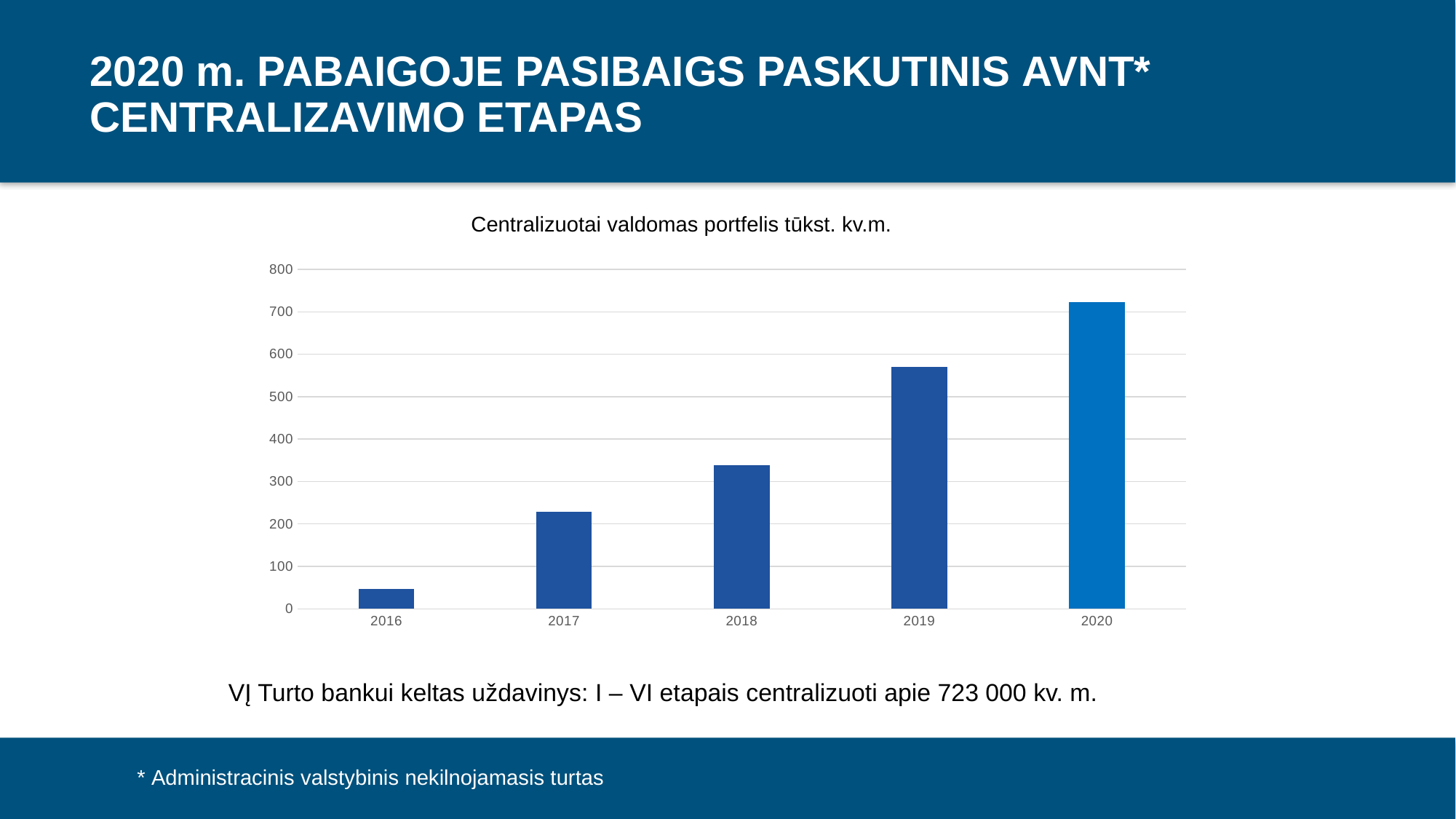
What type of chart is shown on the slide? bar chart Which year has the highest value in the chart? 2020 How many years are shown on the x axis of the chart? 5 Is the value for 2019 greater or less than 500? greater Which is larger, the value for 2018 or the value for 2019? 2019 What is the title of the chart? Centralizuotai valdomas portfelis tūkst. kv.m. Is the value for 2017 greater or less than 200? greater Do the values rise or fall from 2016 to 2020? rise Is the value for 2018 greater or less than 400? less Which year has the lowest value in the chart? 2016